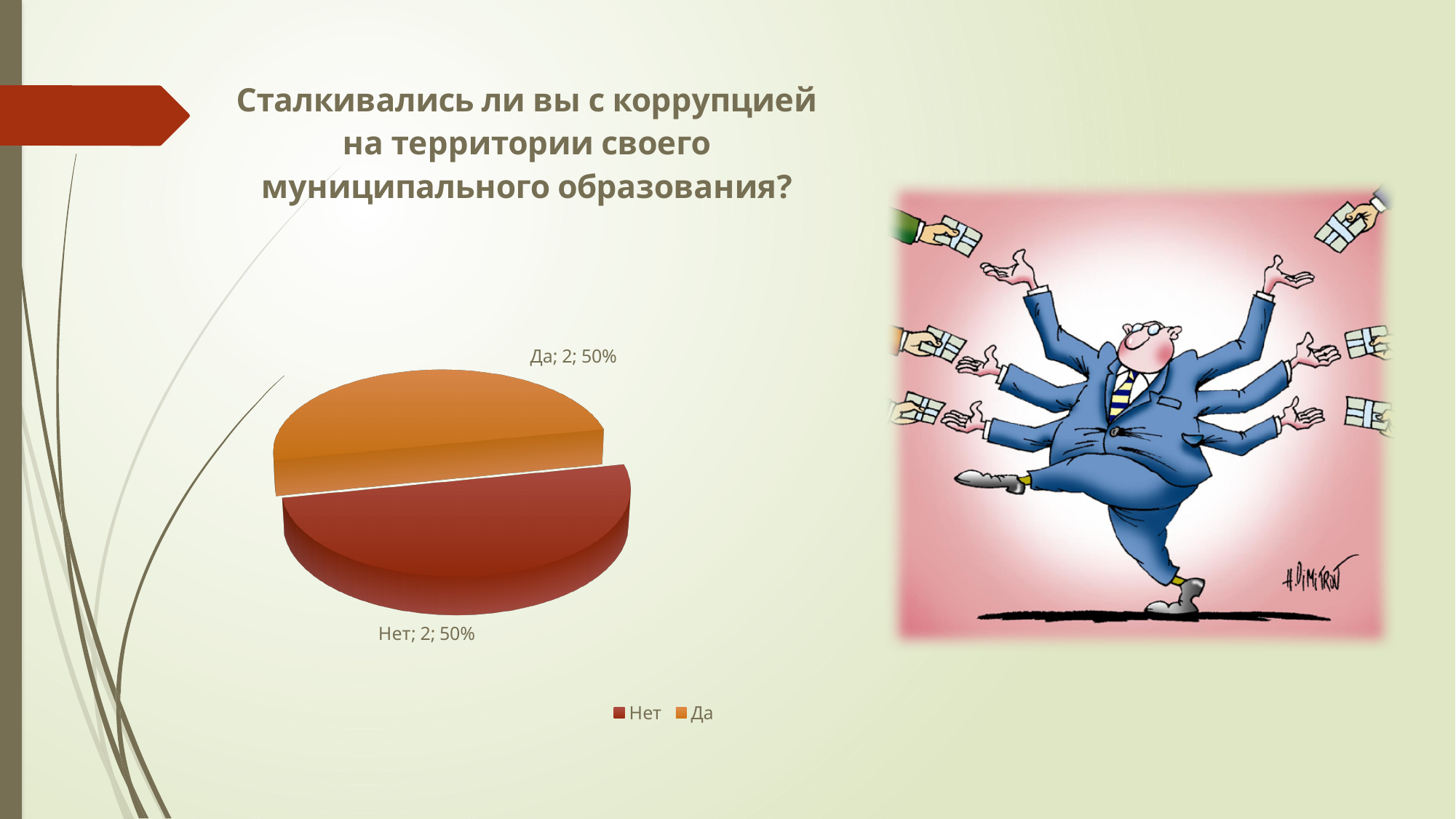
What is the value shown for the "Нет" slice of the pie chart? 2 How many slices does the pie chart have? 2 How many entries does the legend of the pie chart list? 2 What kind of chart is shown on the slide? pie chart What is the total of the values shown for all slices of the pie chart? 4 Which legend entries are listed below the pie chart? Нет, Да What share of the pie does the "Нет" slice represent? 50% What is the difference between the values for "Да" and "Нет" in the pie chart? 0 What is the value shown for the "Да" slice of the pie chart? 2 What colour is the "Да" slice of the pie chart? orange What share of the pie does the "Да" slice represent? 50%